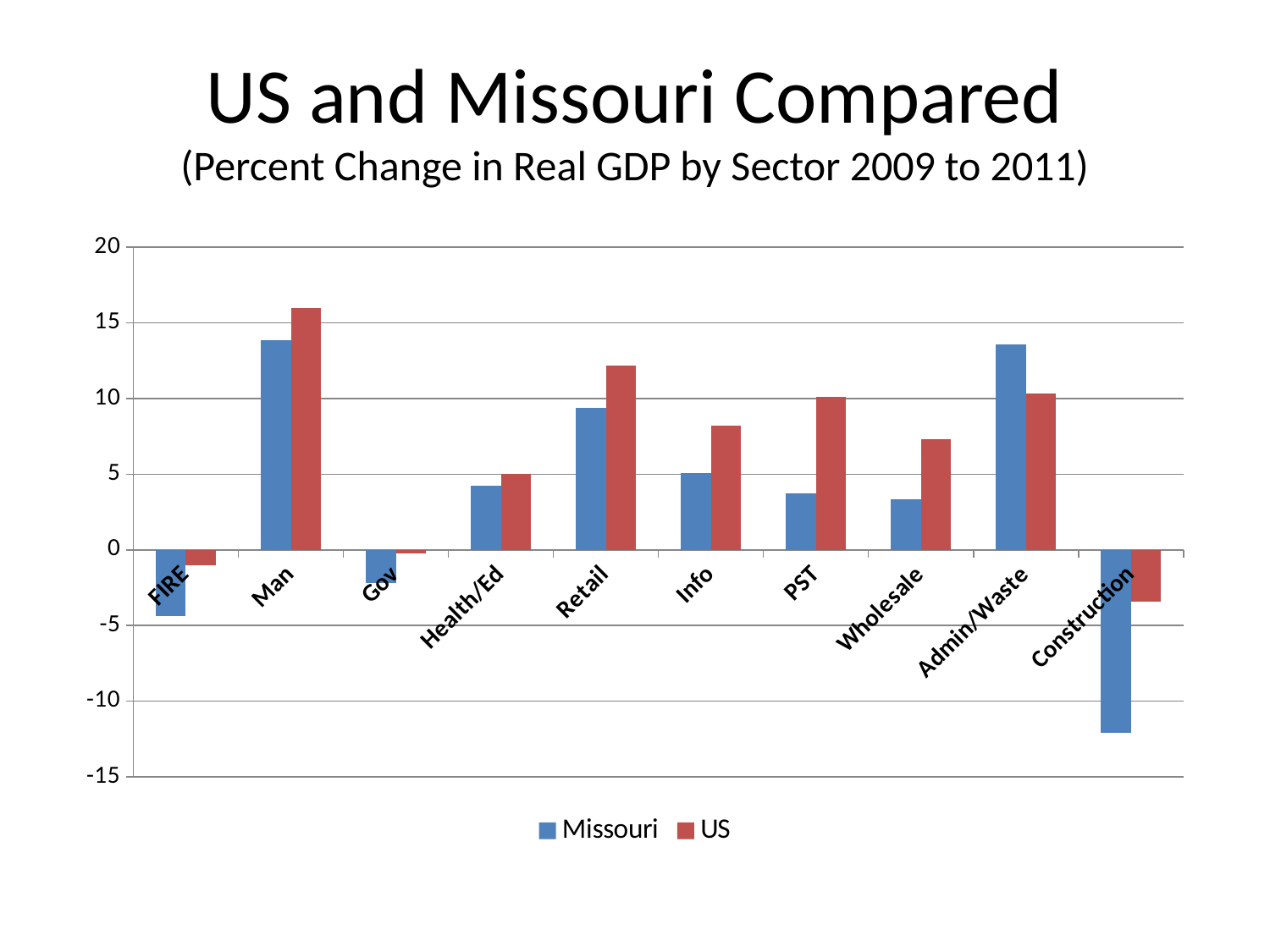
What is the subtitle of the chart shown on the slide? (Percent Change in Real GDP by Sector 2009 to 2011) How many sectors are shown on the x axis of the chart? 10 What kind of chart is shown on the slide? bar chart For Admin/Waste, which is larger, the Missouri value or the US value? Missouri For PST, which is larger, the Missouri value or the US value? US Is the US value for Retail greater or less than 10? greater Is the Missouri value for Admin/Waste greater or less than 10? greater Is the Missouri value for Construction greater or less than -10? less How many series does the legend list? 2 Which sector has the highest US value? Man Which sector has the lowest Missouri value? Construction